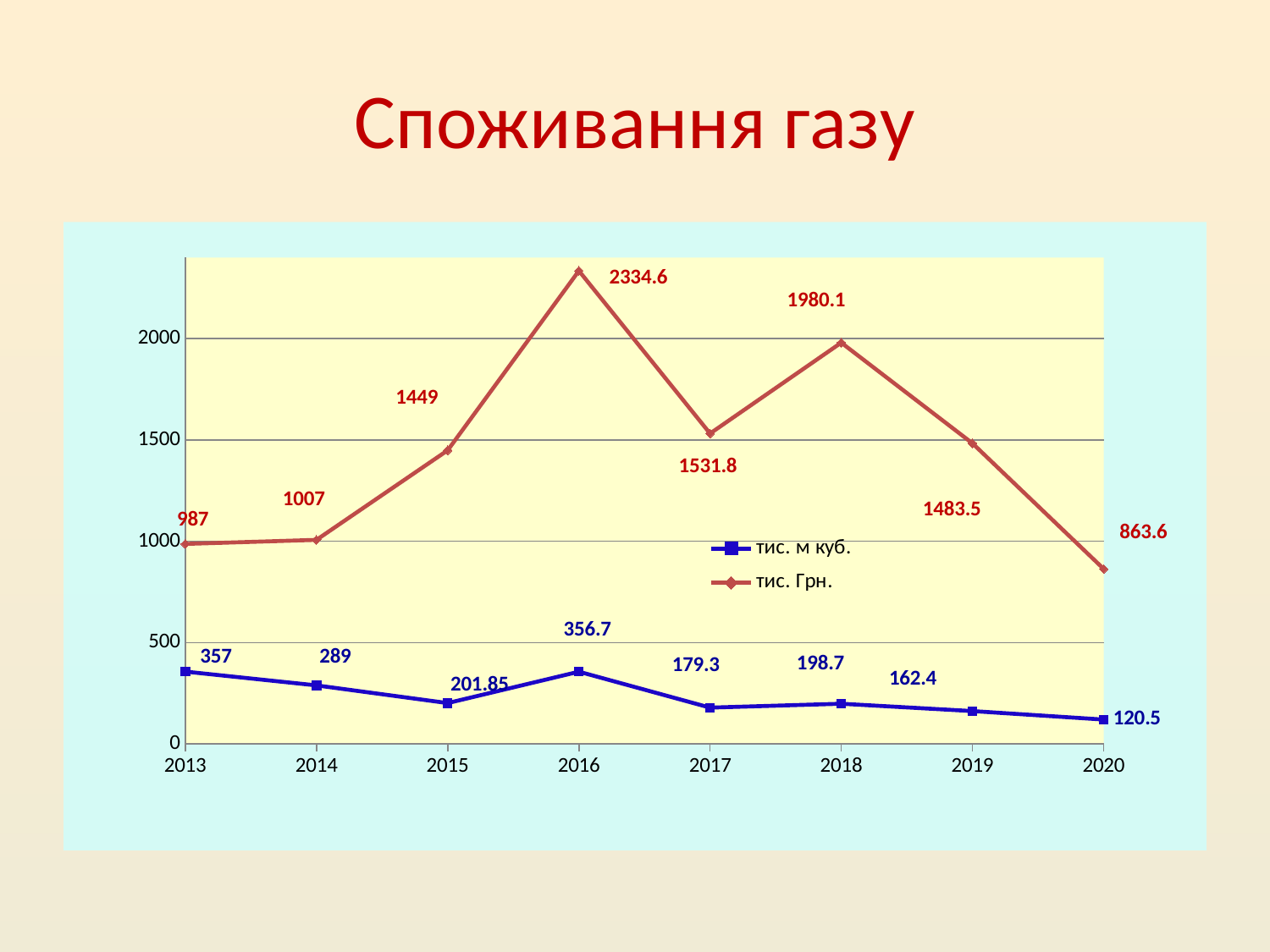
In which year is the "тис. Грн." series highest? 2016 What kind of chart is shown on the slide? line chart What is the value of the "тис. Грн." series in 2020? 863.6 How many series does the legend list? 2 In which year is the "тис. м куб." series lowest? 2020 What is the value of the "тис. Грн." series in 2016? 2334.6 What is the difference between the "тис. Грн." values for 2016 and 2017? 802.8 What is the title of the slide? Споживання газу Which is larger for the "тис. м куб." series: the value in 2013 or the value in 2016? 2013 How many years are shown on the x axis? 8 Is the "тис. Грн." value for 2018 greater or less than 1500? greater What is the value of the "тис. м куб." series in 2015? 201.85